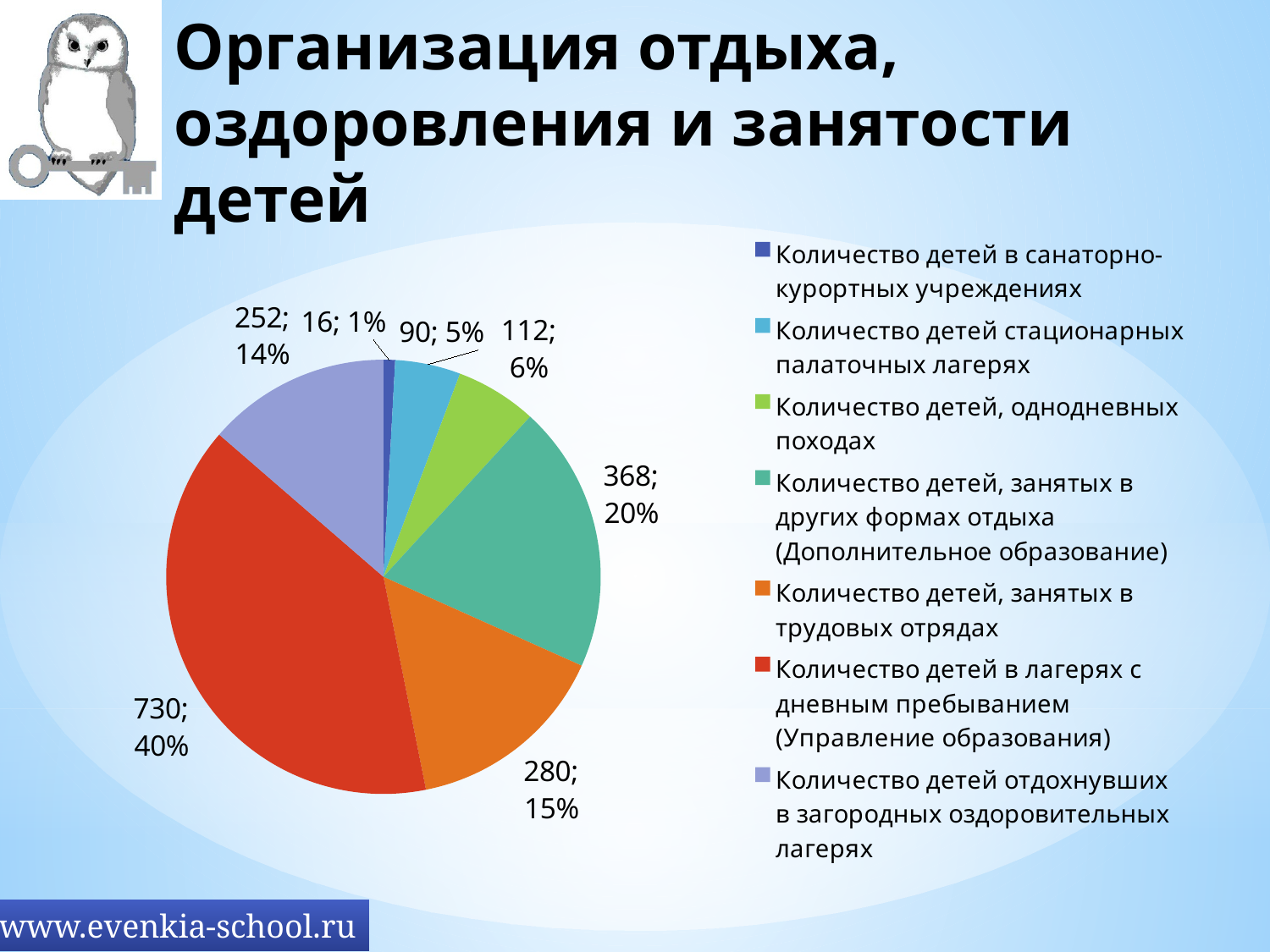
What share of the pie does 'Количество детей отдохнувших в загородных оздоровительных лагерях' take? 14% What share of the pie does 'Количество детей, занятых в других формах отдыха (Дополнительное образование)' take? 20% Which category has the largest slice? Количество детей в лагерях с дневным пребыванием (Управление образования) What is the value for 'Количество детей в лагерях с дневным пребыванием (Управление образования)'? 730 What is the value for 'Количество детей, занятых в трудовых отрядах'? 280 What kind of chart is shown on the slide? pie chart Which is larger: the value for 'Количество детей, одноднeвных походах' or the value for 'Количество детей отдохнувших в загородных оздоровительных лагерях'? Количество детей отдохнувших в загородных оздоровительных лагерях What is the value for 'Количество детей стационарных палаточных лагерях'? 90 What is the difference between the value for 'Количество детей, занятых в других формах отдыха (Дополнительное образование)' and the value for 'Количество детей, занятых в трудовых отрядах'? 88 How many slices does the pie chart have? 7 How many entries does the legend list? 7 Which category has the smallest slice? Количество детей в санаторно-курортных учреждениях